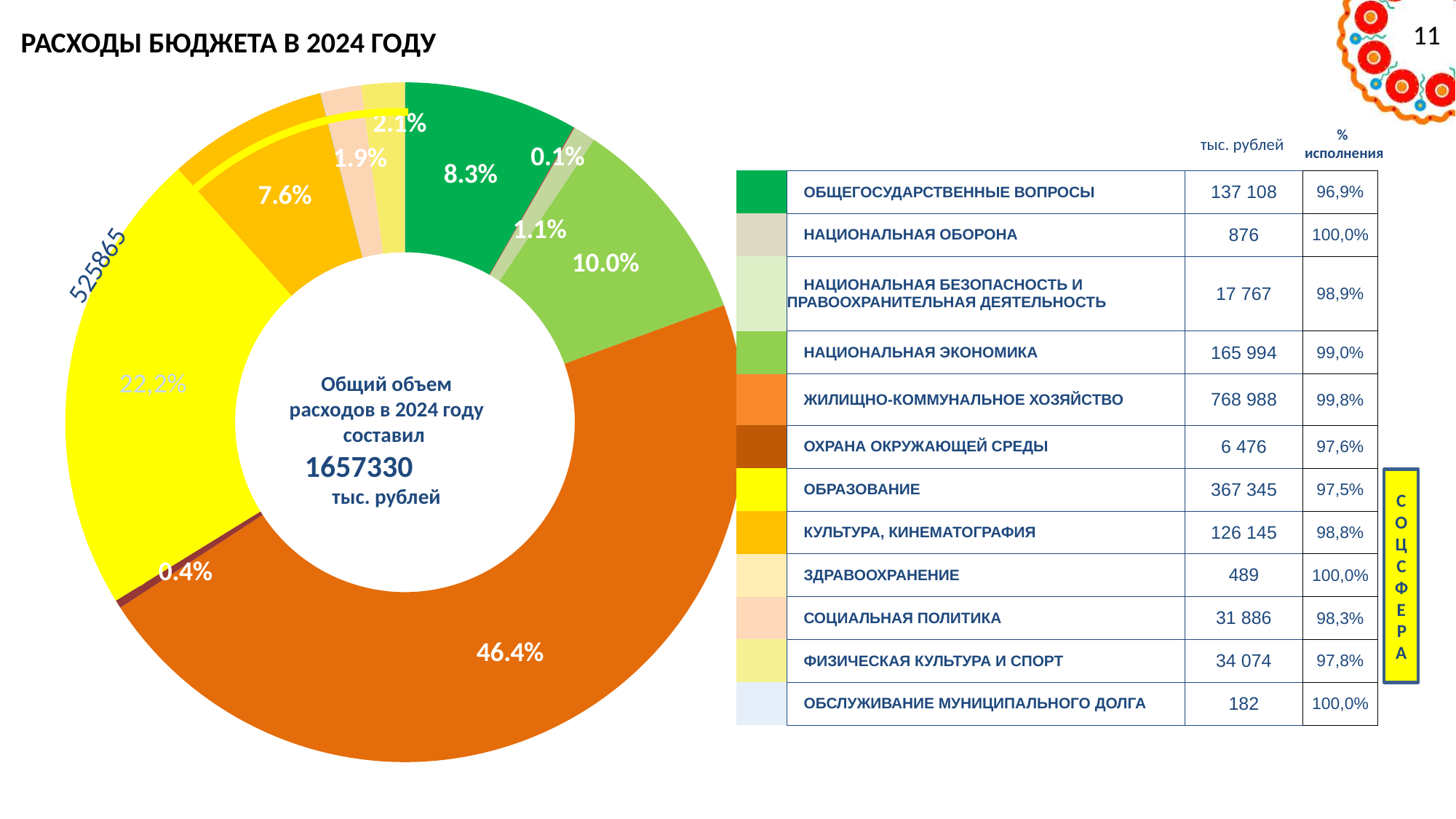
What share of the pie does ЖИЛИЩНО-КОММУНАЛЬНОЕ ХОЗЯЙСТВО take? 46.4% What share of the pie does НАЦИОНАЛЬНАЯ ЭКОНОМИКА take? 10.0% What share of the pie does ОБРАЗОВАНИЕ take? 22.2% What is the difference in percentage points between the ЖИЛИЩНО-КОММУНАЛЬНОЕ ХОЗЯЙСТВО slice (46.4%) and the ОБРАЗОВАНИЕ slice (22.2%)? 24.2 percentage points What kind of chart is shown on the slide? Pie (donut) chart Which category has the largest slice of the pie? ЖИЛИЩНО-КОММУНАЛЬНОЕ ХОЗЯЙСТВО What is the title of the slide? РАСХОДЫ БЮДЖЕТА В 2024 ГОДУ What is the total volume of expenditures in 2024 shown in the centre of the chart, in тыс. рублей? 1657330 How many expenditure categories are listed in the legend table next to the chart? 12 Which slice is larger: ОБЩЕГОСУДАРСТВЕННЫЕ ВОПРОСЫ or НАЦИОНАЛЬНАЯ ЭКОНОМИКА? НАЦИОНАЛЬНАЯ ЭКОНОМИКА What is the value in тыс. рублей for ОБРАЗОВАНИЕ in the legend table? 367 345